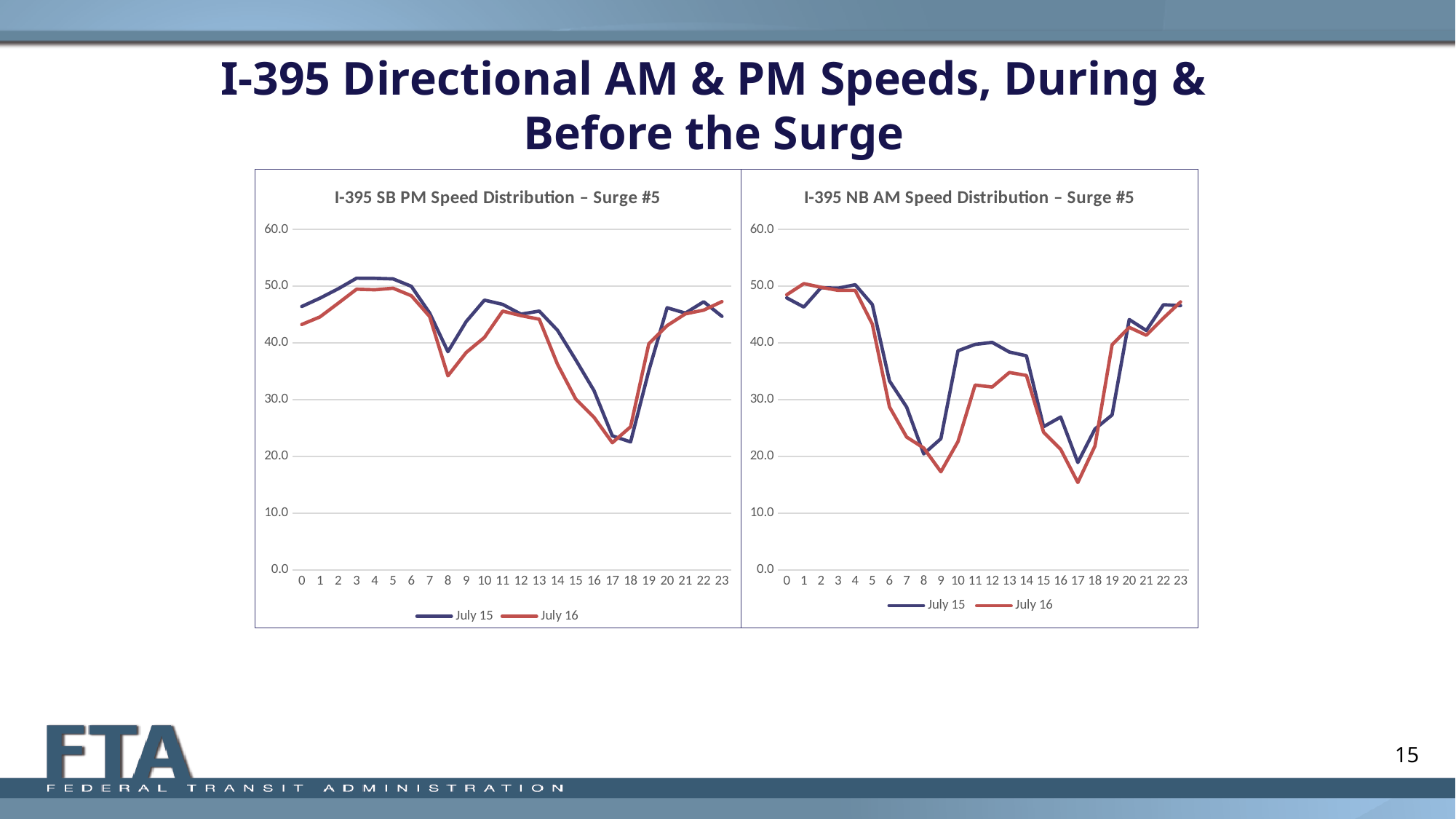
How many series does the legend of the I-395 NB AM Speed Distribution chart list? 2 In the I-395 SB PM Speed Distribution chart, is the July 15 value at hour 3 greater or less than 50.0? greater What kind of chart is the I-395 SB PM Speed Distribution chart? line chart In the I-395 NB AM Speed Distribution chart, is the July 16 value at hour 9 greater or less than 20.0? less In the I-395 NB AM Speed Distribution chart, which series has the larger value at hour 10, July 15 or July 16? July 15 In the I-395 NB AM Speed Distribution chart, does the July 15 line rise or fall from hour 17 to hour 22? rise How many hourly points are plotted along the x axis of the I-395 SB PM Speed Distribution chart? 24 In the I-395 SB PM Speed Distribution chart, is the July 16 value at hour 8 greater or less than 40.0? less In the I-395 SB PM Speed Distribution chart, does the July 16 line rise or fall from hour 13 to hour 17? fall What is the title of the chart on the right side of the slide? I-395 NB AM Speed Distribution – Surge #5 In the I-395 SB PM Speed Distribution chart, which series has the larger value at hour 15, July 15 or July 16? July 15